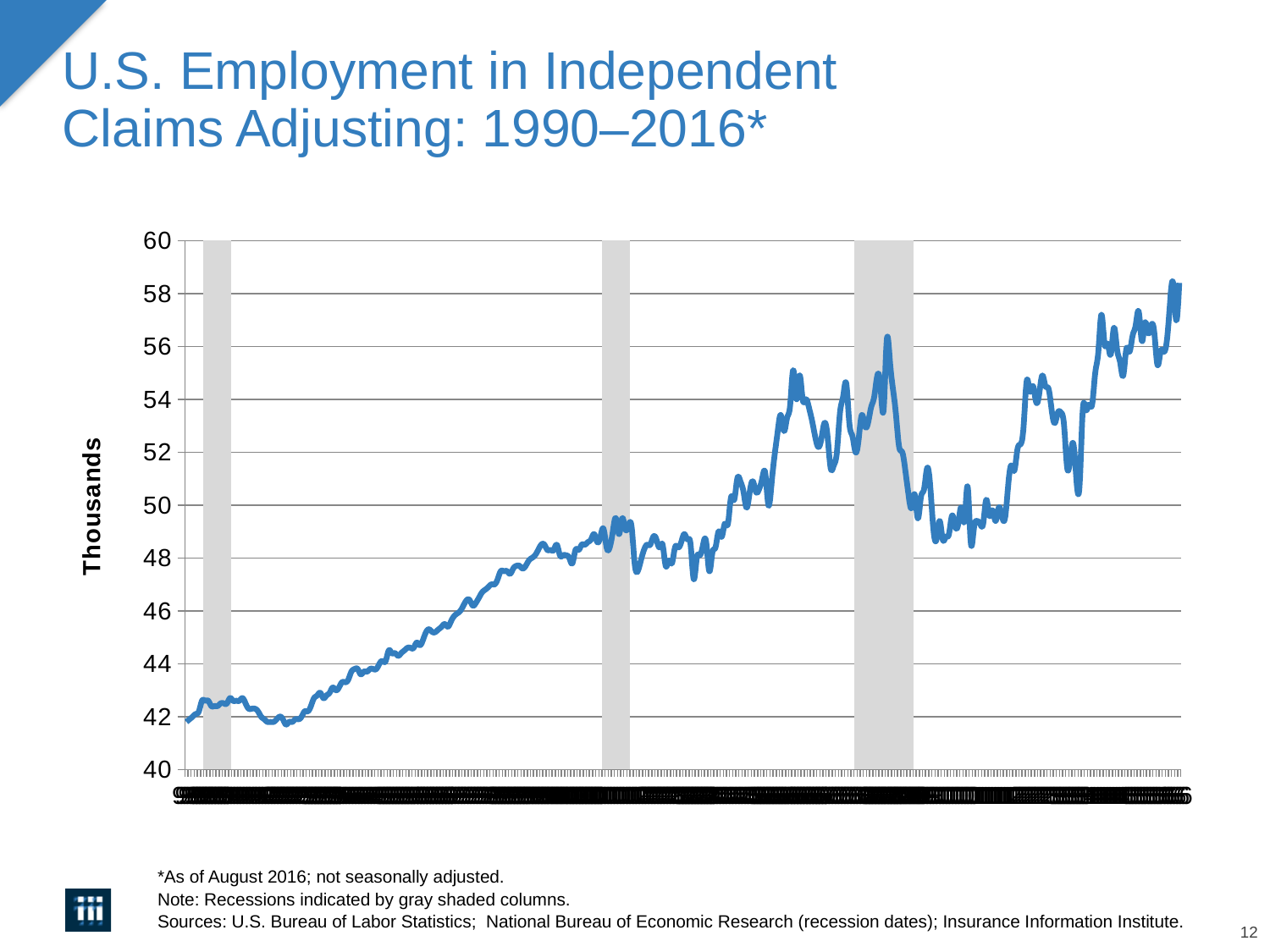
What is the label on the vertical axis of the chart? Thousands Overall, do the values rise or fall from the start of the series to the end? rise Is the value at the start of the series greater or less than 44? less Is the lowest value reached by the line greater or less than 44? less Is the value at the end of the series greater or less than the value at the start of the series? greater How many gray shaded recession columns are shown on the chart? 3 Is the highest value reached by the line greater or less than 58? greater What kind of chart is shown on the slide? line chart